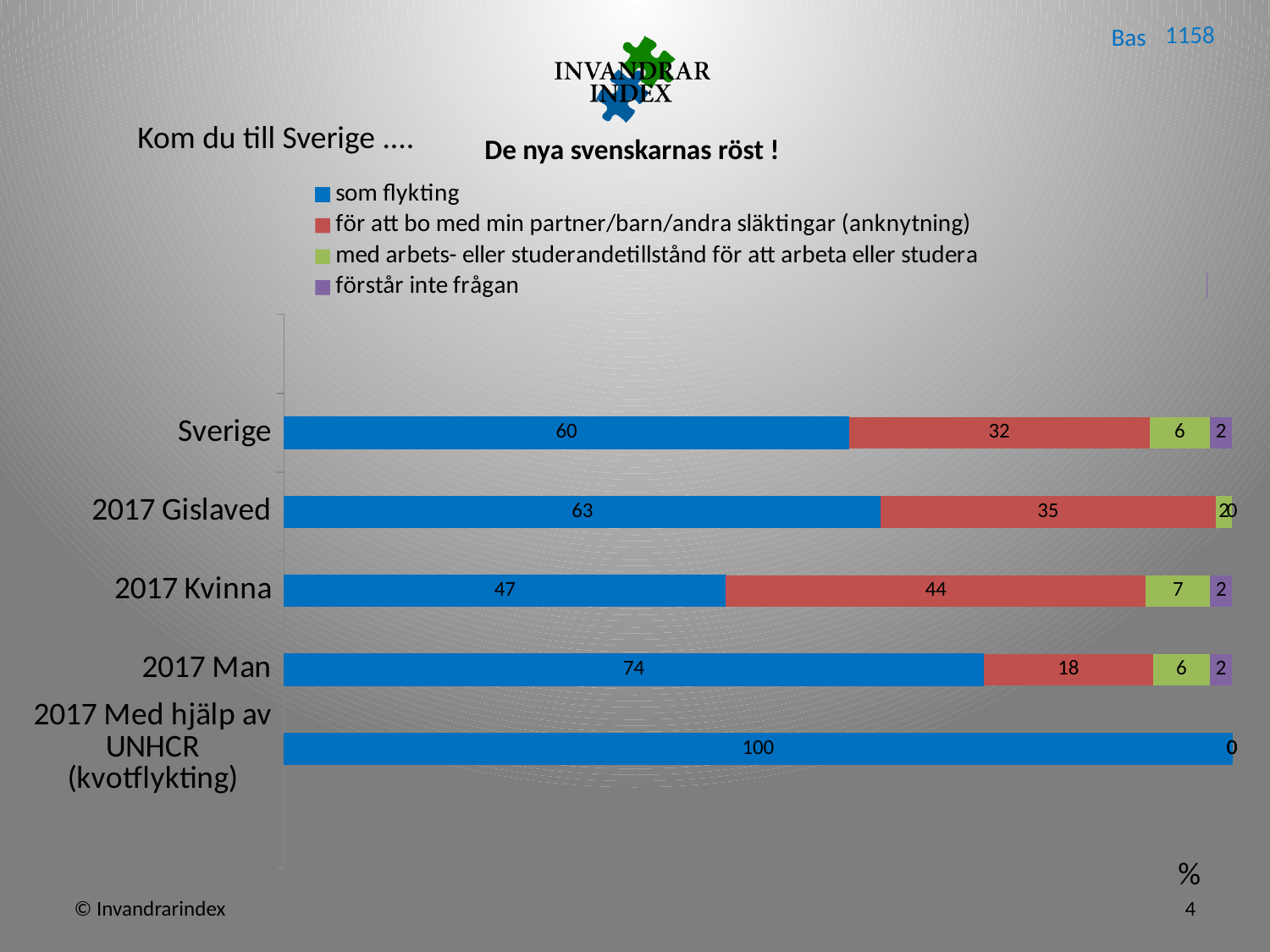
Which category has the lowest value for 'som flykting'? 2017 Kvinna What is the value for 'som flykting' in the Sverige bar? 60 What is the difference between the 'som flykting' values for 2017 Man and 2017 Kvinna? 27 Which is larger: the 'för att bo med min partner/barn/andra släktingar (anknytning)' value for 2017 Gislaved or for 2017 Man? 2017 Gislaved Which category has the highest value for 'som flykting'? 2017 Med hjälp av UNHCR (kvotflykting) How many categories are plotted on the chart? 5 How many series does the legend list? 4 What is the value for 'med arbets- eller studerandetillstånd för att arbeta eller studera' in the 2017 Kvinna bar? 7 What is the total of the Sverige stacked bar? 100 What is the value for 'som flykting' in the 2017 Man bar? 74 What is the value for 'för att bo med min partner/barn/andra släktingar (anknytning)' in the 2017 Kvinna bar? 44 What kind of chart is shown on the slide? stacked bar chart